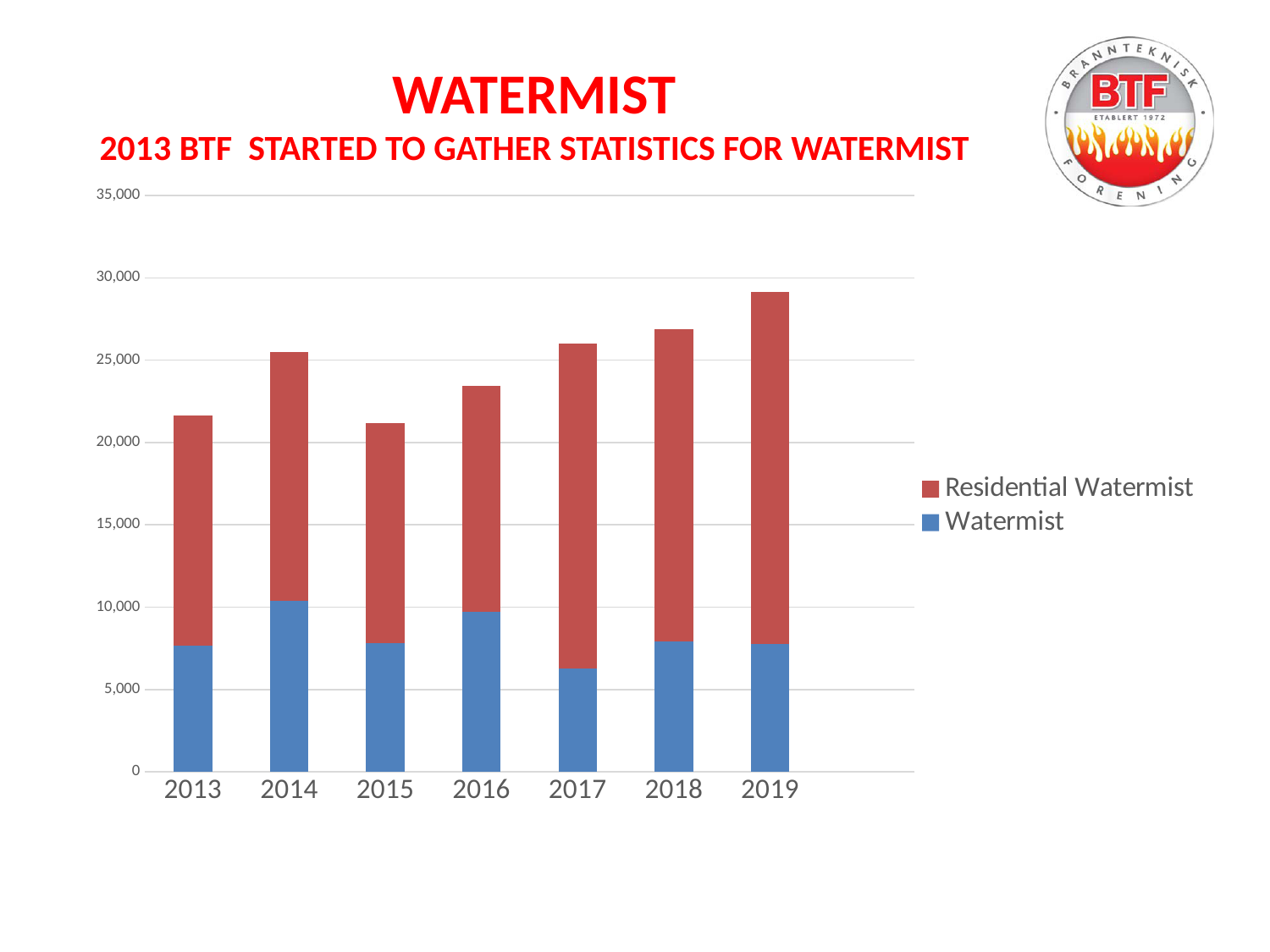
How many years are shown on the x axis of the chart? 7 Which year has the larger total stacked bar, 2014 or 2016? 2014 Is the total stacked bar for 2015 greater or less than 25,000? less How many series does the chart legend list? 2 Is the total stacked bar for 2019 greater or less than 25,000? greater Is the Watermist value for 2014 greater or less than 10,000? greater Which colour represents Residential Watermist in the chart legend? red Which year has the tallest total stacked bar? 2019 Which year has the highest Watermist (blue) value? 2014 Which year has the lowest Watermist (blue) value? 2017 What kind of chart is shown on the slide? stacked bar chart